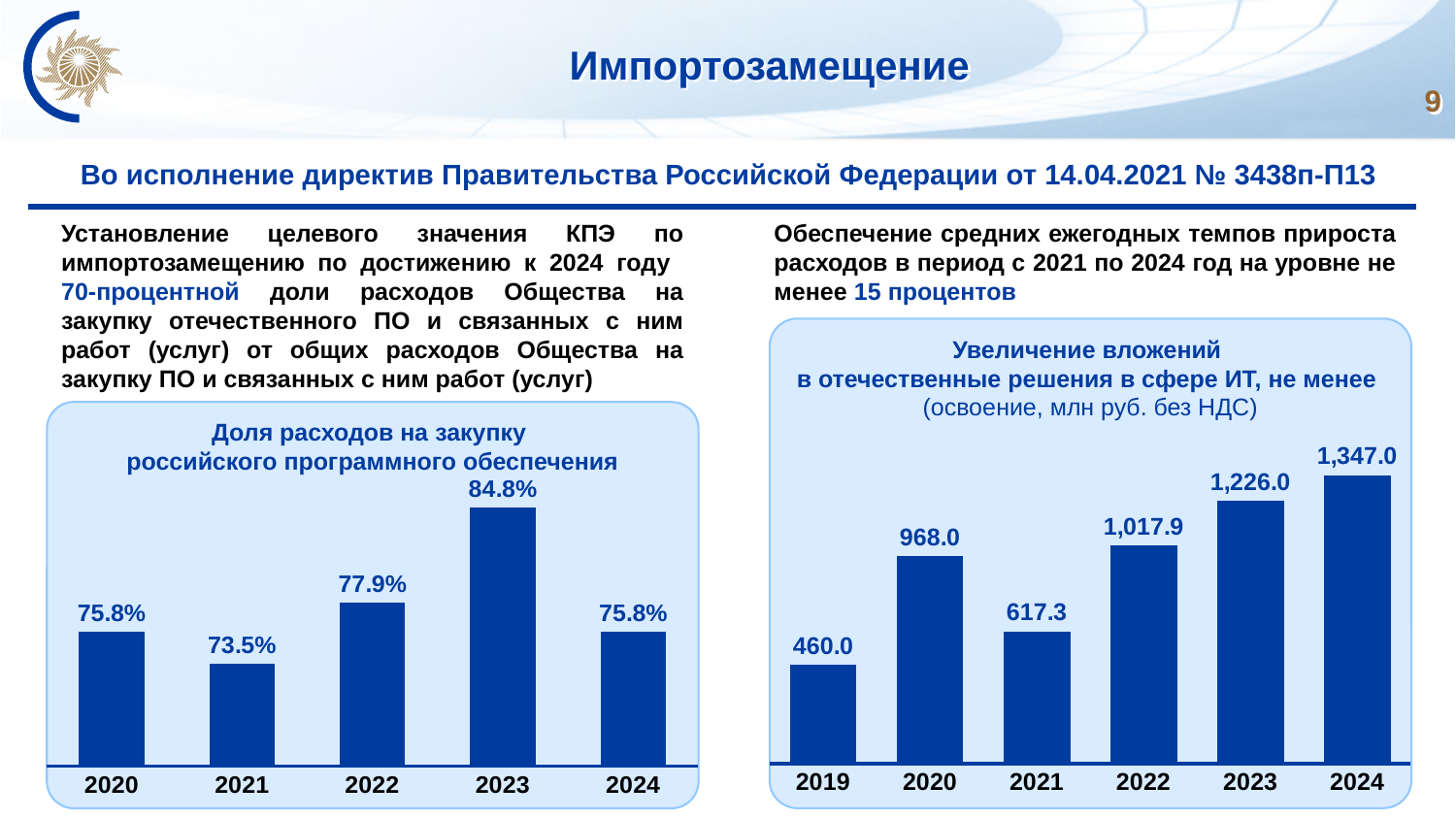
In the left chart, what is the difference between the values for 2023 and 2022? 6.9% In the right chart, which year has the lowest value? 2019 In the right chart (Увеличение вложений в отечественные решения в сфере ИТ), what is the value for 2021? 617.3 In the right chart, what is the value for 2024? 1,347.0 In the left chart, what is the value for 2021? 73.5% In the left chart (Доля расходов на закупку российского программного обеспечения), what is the value for 2023? 84.8% In the left chart, which year has the lowest value? 2021 In the left chart, how many years are shown on the x axis? 5 In the left chart, which year has the highest value? 2023 What type of chart is the right chart? Bar chart In the right chart, which is larger, the value for 2020 or the value for 2021? 2020 In the right chart, what is the difference between the values for 2024 and 2023? 121.0